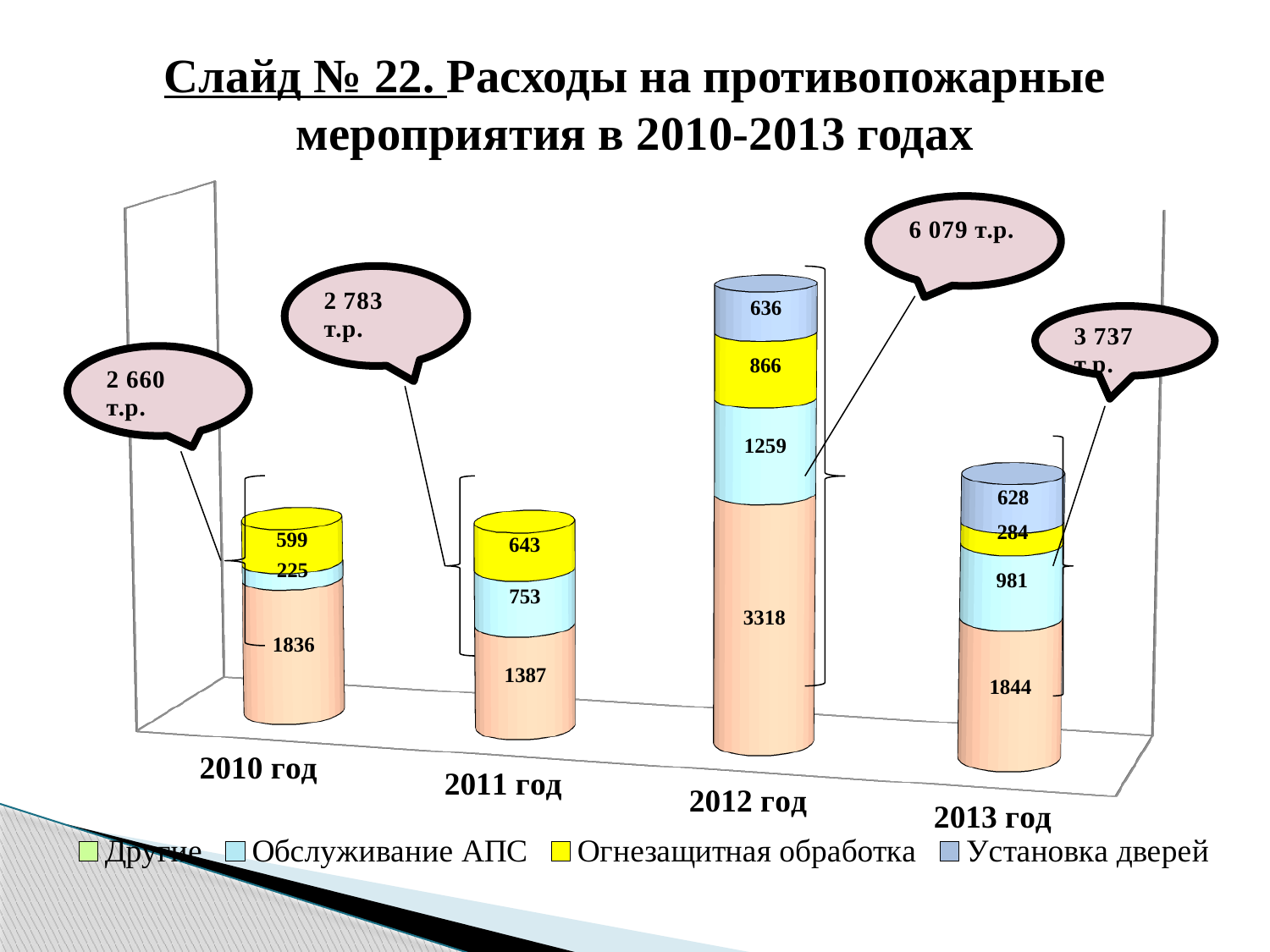
Which year has the lowest total expenditure? 2010 год How many series does the legend list? 4 Which year has the larger value for Огнезащитная обработка, 2010 год or 2011 год? 2011 год What is the difference between the Обслуживание АПС values for 2012 год and 2013 год? 278 What is the value for Обслуживание АПС in 2011 год? 753 What kind of chart is shown on the slide? Stacked bar chart What is the value for Огнезащитная обработка in 2012 год? 866 How many years (categories) are shown on the x axis? 4 Which series is shown in yellow in the legend? Огнезащитная обработка What is the total of the stacked bar for 2012 год, as shown in the callout? 6 079 т.р. Which year has the highest total expenditure? 2012 год What is the value for Установка дверей in 2013 год? 628